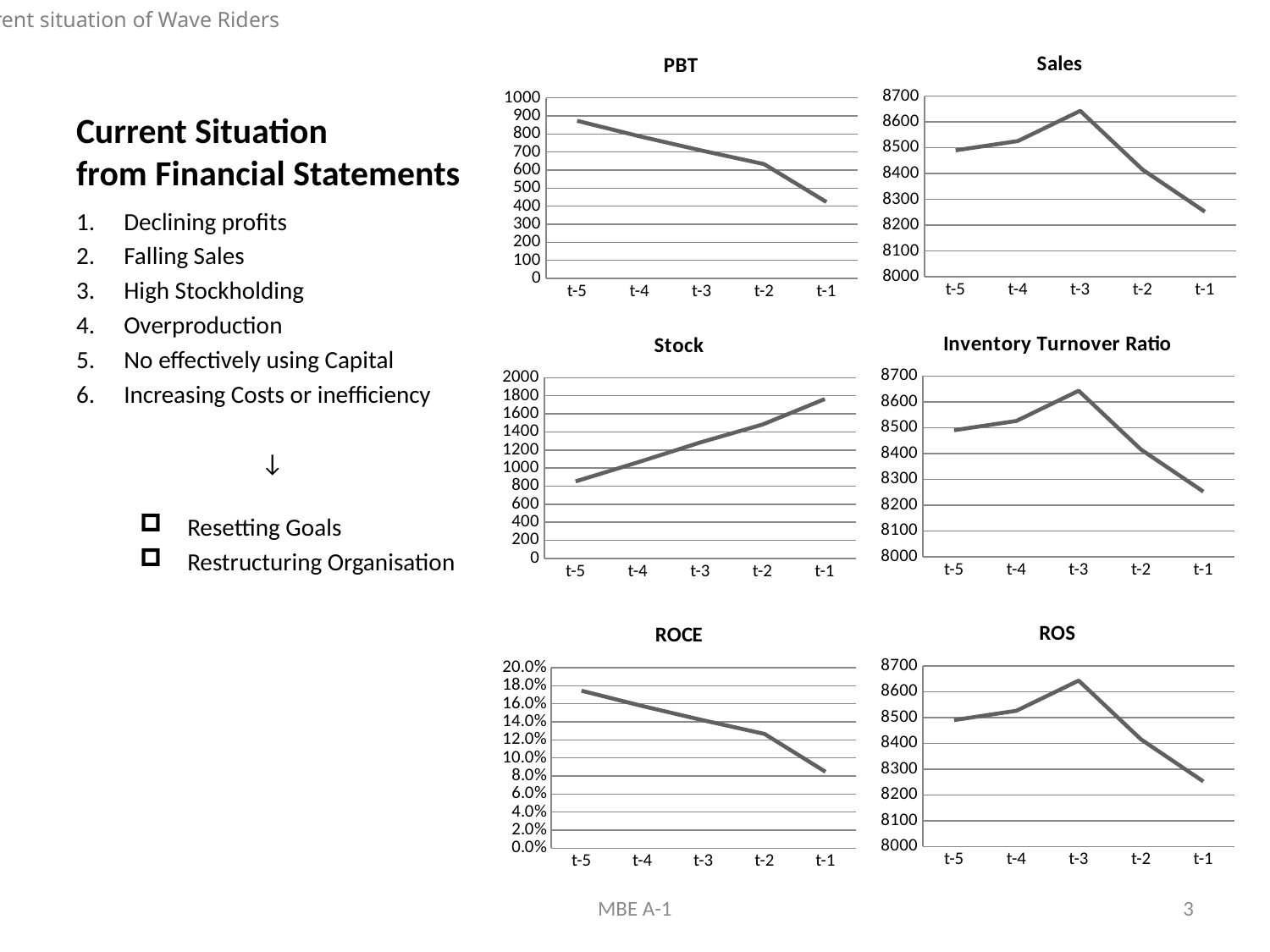
In the Stock chart, do the values rise or fall from t-5 to t-1? rise In the PBT chart, which period has the highest value? t-5 In the Sales chart, which period has the lowest value? t-1 In the Sales chart, which period has the highest value? t-3 In the Inventory Turnover Ratio chart, which is larger, the value for t-3 or the value for t-1? t-3 In the ROCE chart, is the value for t-5 greater or less than 16.0%? greater How many periods are plotted in the Stock chart? 5 In the PBT chart, do the values rise or fall from t-5 to t-1? fall What kind of chart is the PBT chart? line chart In the Stock chart, is the value for t-1 greater or less than 1600? greater In the PBT chart, is the value for t-1 greater or less than 500? less In the ROCE chart, which period has the lowest value? t-1